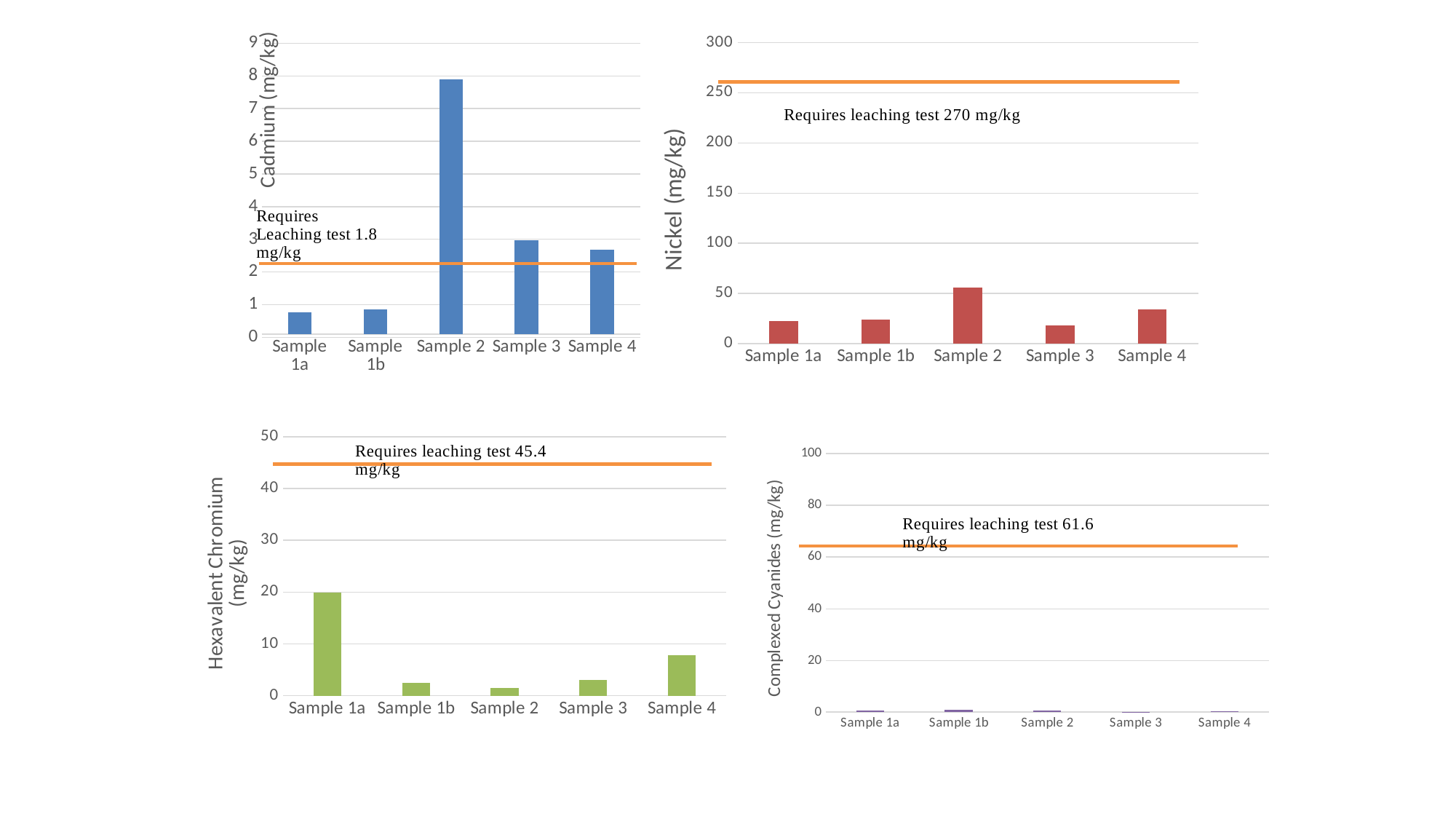
In the Nickel chart (top right), which sample has the lowest nickel value? Sample 3 In the Nickel chart (top right), which sample has the highest nickel value? Sample 2 In the Hexavalent Chromium chart (bottom left), is the value for Sample 4 greater or less than 10? less In the Cadmium chart (top left), is the value for Sample 1a greater or less than 1? less How many samples are plotted in the Complexed Cyanides chart (bottom right)? 5 In the Nickel chart (top right), is the value for Sample 4 greater or less than 50? less In the Hexavalent Chromium chart (bottom left), which is larger, the value for Sample 1a or Sample 4? Sample 1a In the Cadmium chart (top left), which sample has the highest cadmium value? Sample 2 In the Nickel chart (top right), what leaching test threshold is stated in the annotation? 270 mg/kg What kind of chart is the Nickel chart (top right)? bar chart In the Hexavalent Chromium chart (bottom left), which sample has the highest value? Sample 1a